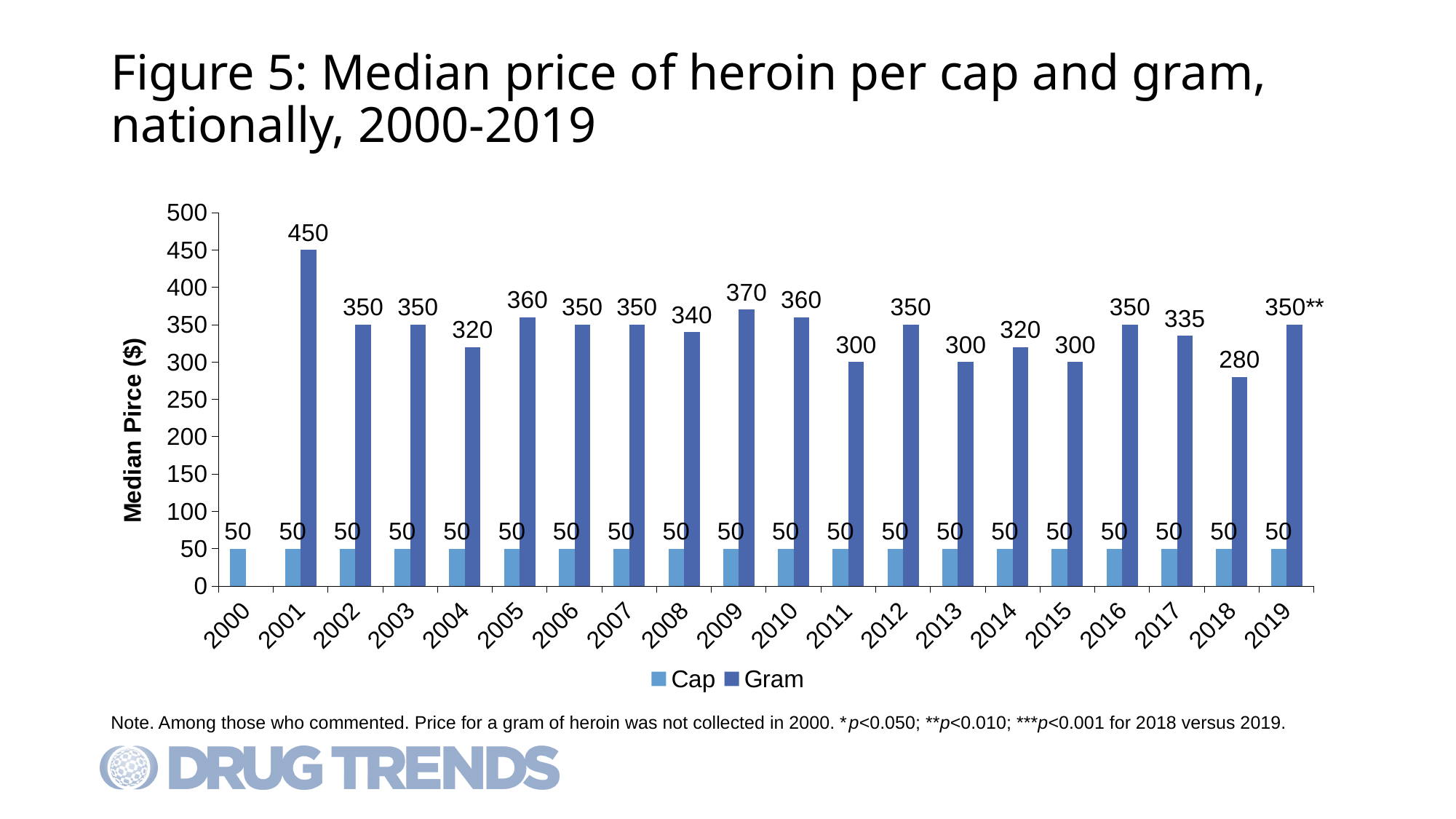
What is the median price per gram of heroin in 2018? 280 In which year is the median price per gram highest? 2001 What kind of chart is shown? Bar chart What is the median price per cap of heroin in 2010? 50 Which is larger, the median price per gram in 2009 or in 2017? 2009 What is the difference between the median price per gram in 2019 and in 2018? 70 What is the median price per gram of heroin in 2001? 450 How many years are shown on the x axis? 20 In which year is the median price per gram lowest? 2018 What is the label on the y axis? Median Pirce ($) Does the median price per cap change across the years 2000 to 2019? No, it stays at 50 How many series does the legend list? 2